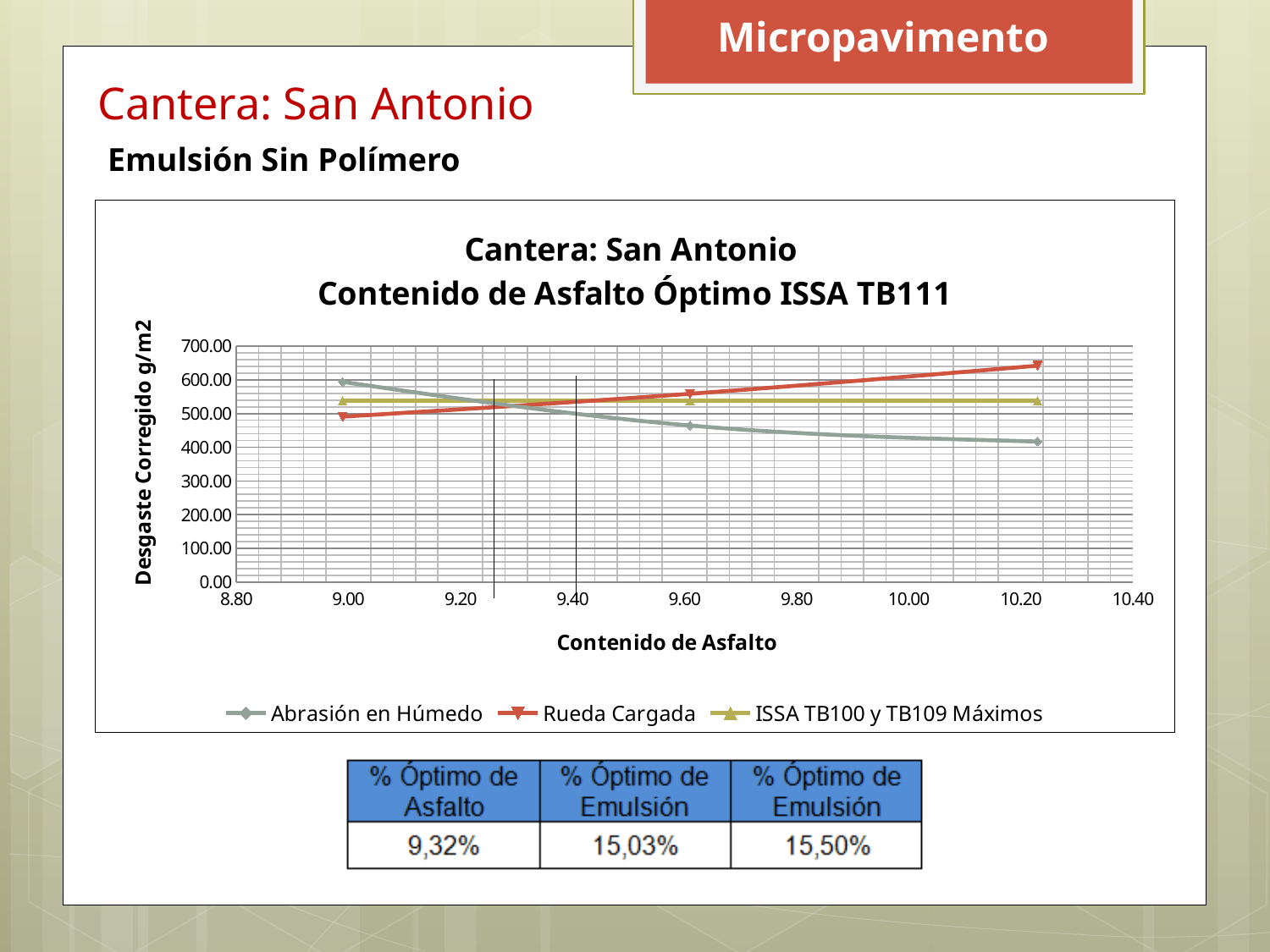
Does the Rueda Cargada series rise or fall as Contenido de Asfalto increases? rise How many data points are plotted for the Abrasión en Húmedo series? 3 Is the ISSA TB100 y TB109 Máximos line greater or less than 600.00? less Is the Rueda Cargada value at the highest Contenido de Asfalto (about 10.20) greater or less than 600.00? greater Does the Abrasión en Húmedo series rise or fall as Contenido de Asfalto increases? fall Is the Abrasión en Húmedo value at a Contenido de Asfalto of 9.00 greater or less than 500.00? greater At a Contenido de Asfalto of 9.00, which series has the larger value: Abrasión en Húmedo or Rueda Cargada? Abrasión en Húmedo How many series does the chart legend list? 3 At a Contenido de Asfalto of about 10.20, which series has the larger value: Abrasión en Húmedo or Rueda Cargada? Rueda Cargada What kind of chart is shown on the slide? line chart What is the label of the vertical axis of the chart? Desgaste Corregido g/m2